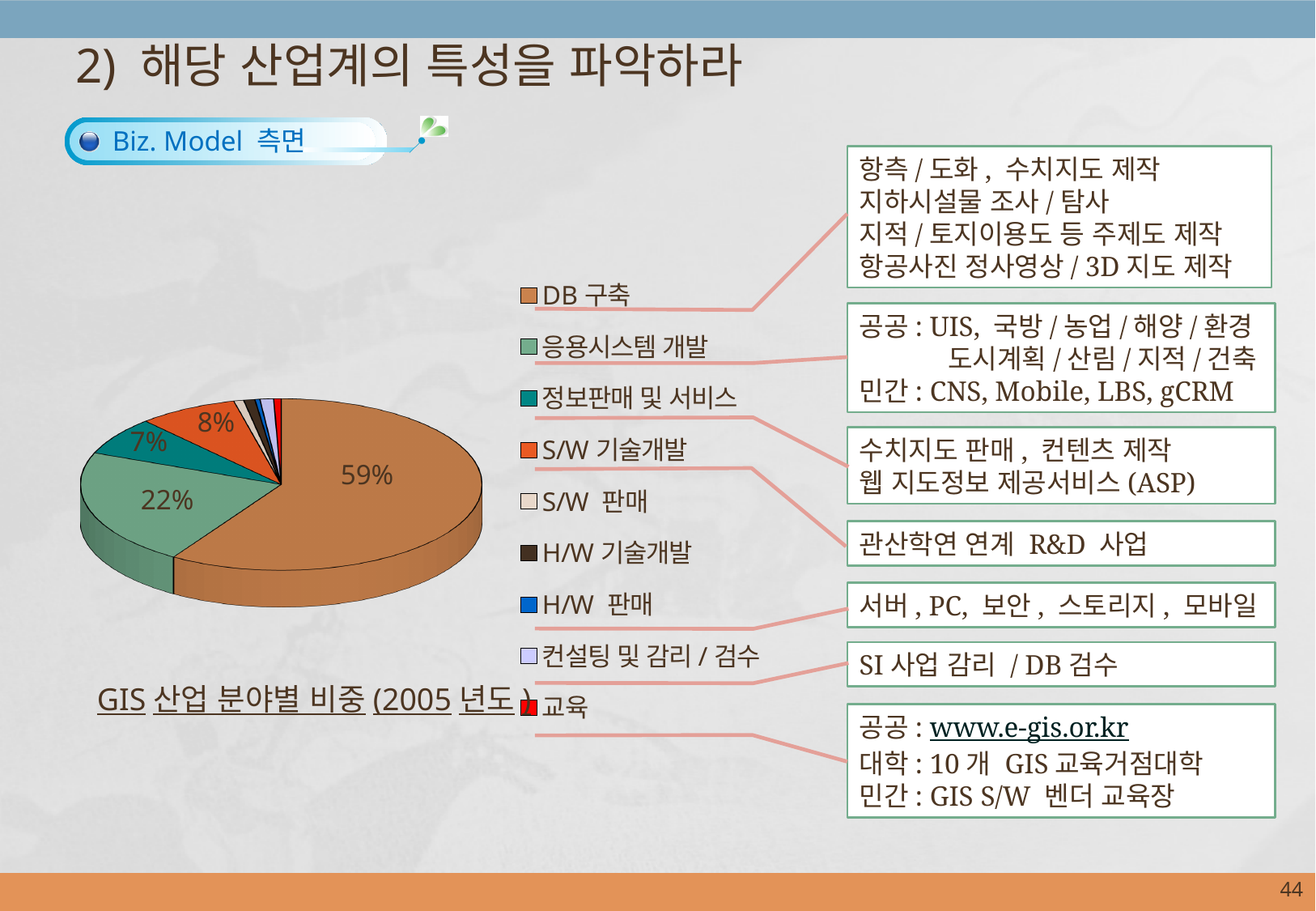
What is the difference in percentage points between the DB 구축 share and the 응용시스템 개발 share? 37 What share of the pie does 정보판매 및 서비스 hold? 7% Which is larger, the share for 응용시스템 개발 or the share for S/W 기술개발? 응용시스템 개발 What share of the pie does 응용시스템 개발 hold? 22% What kind of chart is shown on the slide? pie chart What share of the pie does DB 구축 hold? 59% How many categories does the legend list? 9 What share of the pie does S/W 기술개발 hold? 8% Which is larger, the share for S/W 기술개발 or the share for 정보판매 및 서비스? S/W 기술개발 What is the title of the pie chart? GIS 산업 분야별 비중 (2005 년도) Which category has the largest slice of the pie? DB 구축 Which legend entry is shown in red? 교육